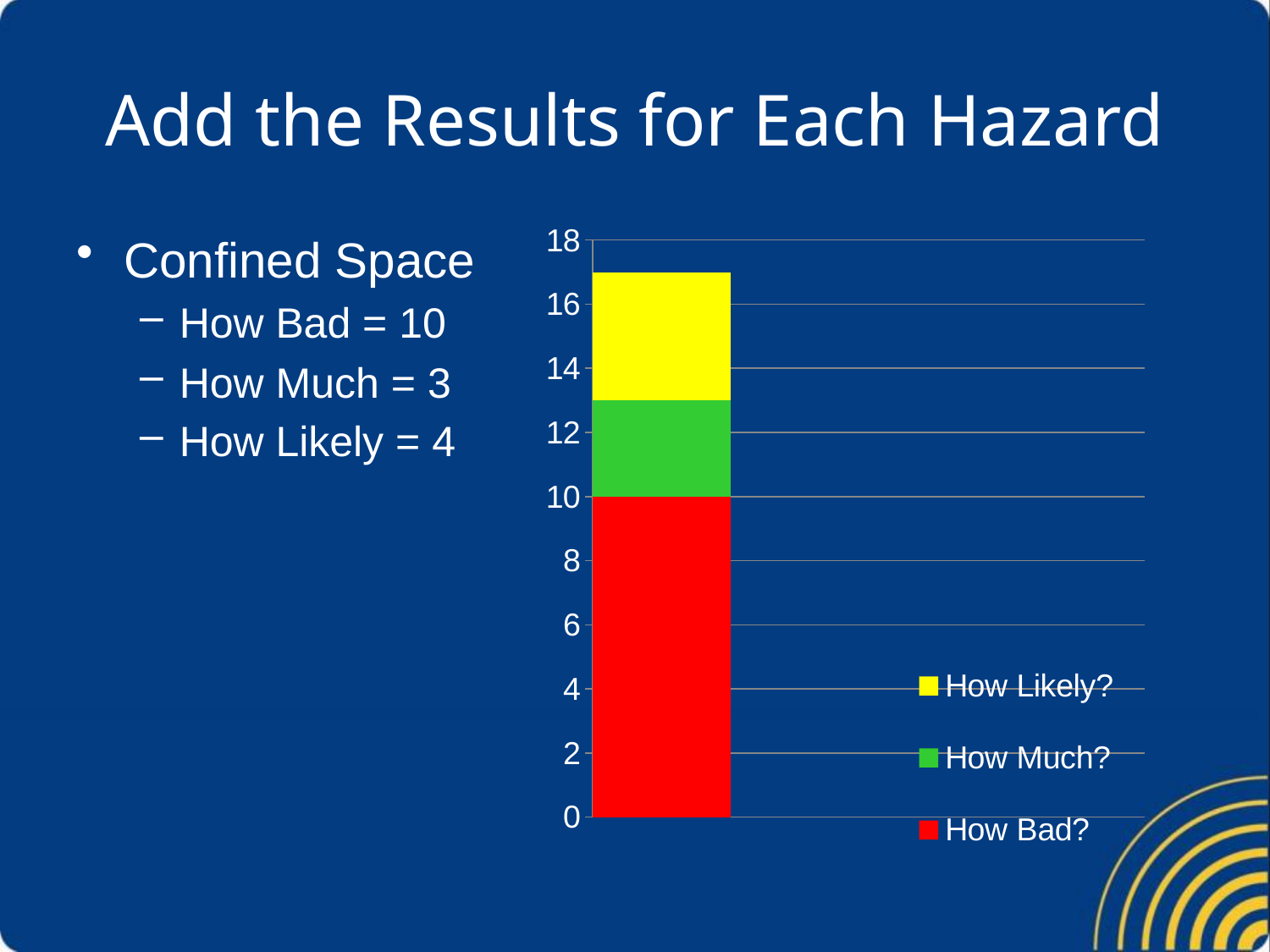
Which series has the smallest segment in the bar? How Much? What is the value of the How Much? segment of the bar? 3 How many series does the chart legend list? 3 How many bars are plotted in the chart? 1 Which series has the largest segment in the bar? How Bad? What is the value of the How Likely? segment of the bar? 4 What is the difference between the How Bad? value and the How Likely? value? 6 Is the total height of the stacked bar greater or less than 16? greater What kind of chart is shown on the slide? stacked bar chart What is the total height of the stacked bar? 17 Which colour represents the How Likely? series in the chart? yellow What is the value of the How Bad? segment of the bar? 10